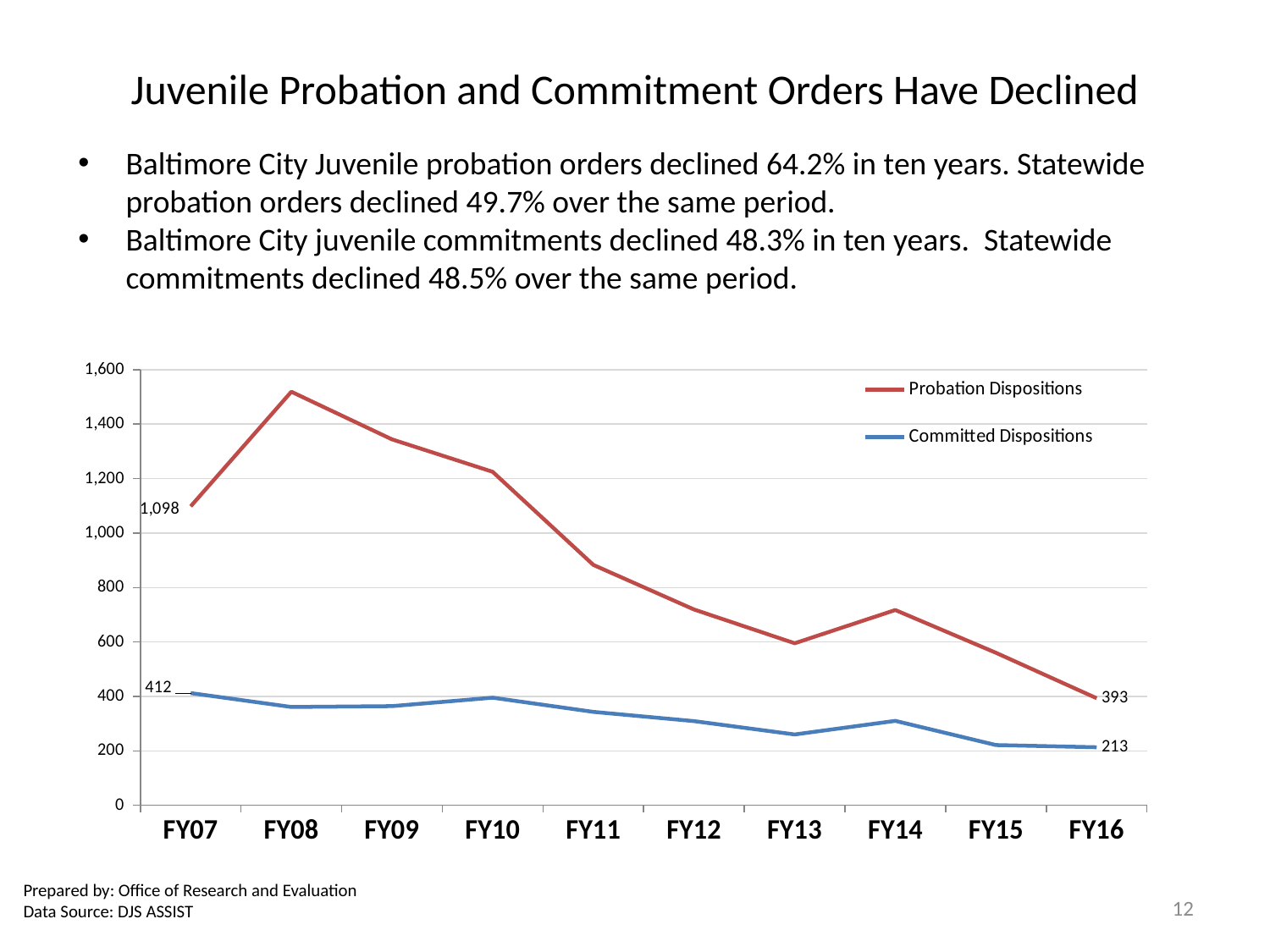
What kind of chart is shown on the slide? line chart By how much did Probation Dispositions decline from FY07 to FY16? 705 How many fiscal years are shown on the x axis? 10 In which fiscal year were Probation Dispositions lowest? FY16 What is the value of Committed Dispositions in FY07? 412 By how much did Committed Dispositions decline from FY07 to FY16? 199 Is the value for Probation Dispositions in FY08 greater or less than 1,400? greater In which fiscal year were Probation Dispositions highest? FY08 How many series does the legend list? 2 What is the value of Committed Dispositions in FY16? 213 What is the value of Probation Dispositions in FY07? 1,098 What is the value of Probation Dispositions in FY16? 393